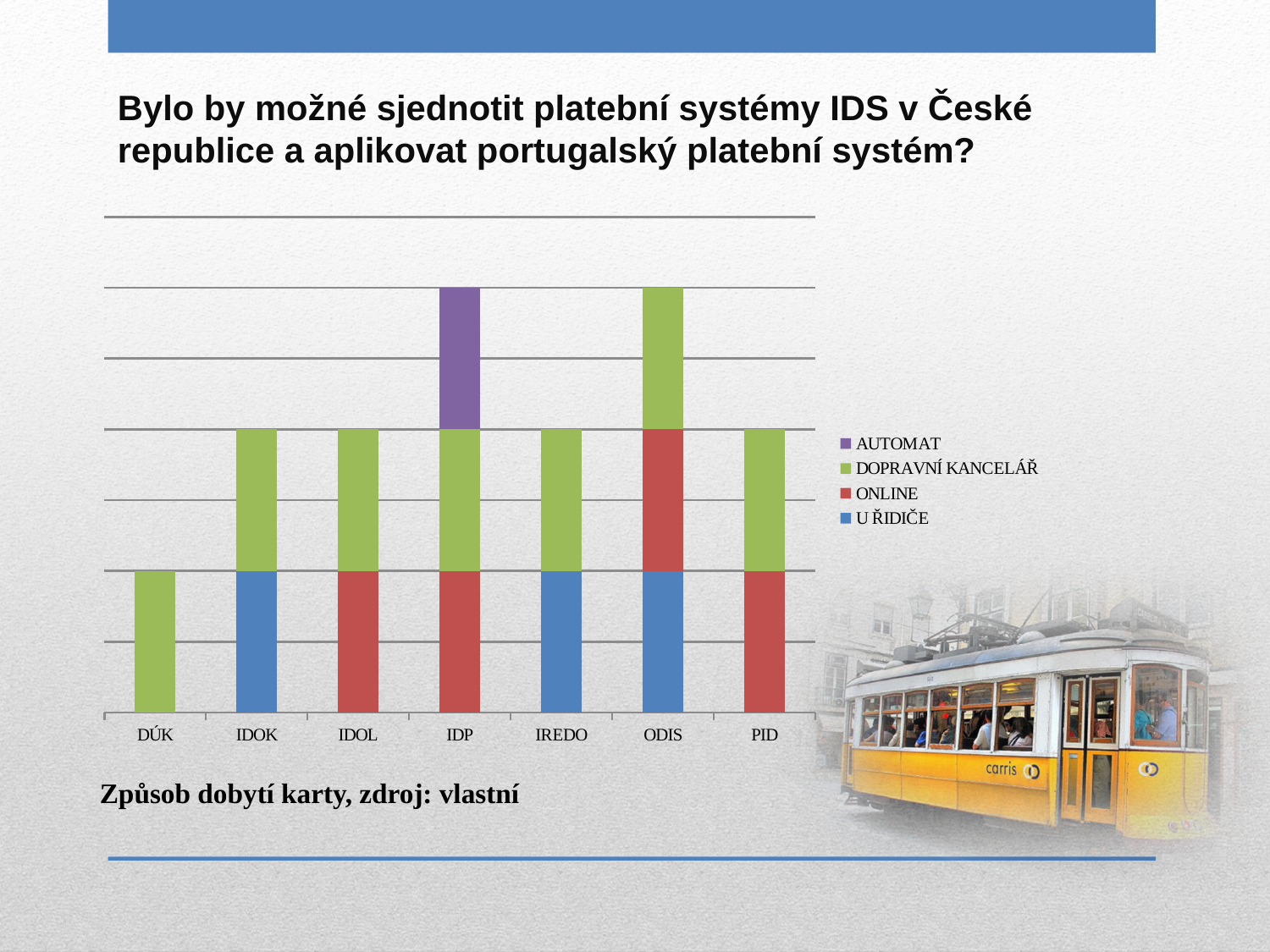
How many categories are shown on the x axis of the chart? 7 What colour represents the ONLINE series in the legend? Red What caption appears below the chart? Způsob dobytí karty, zdroj: vlastní Which stacked bar is taller, ODIS or PID? ODIS What kind of chart is shown on the slide? Stacked bar chart Which category has the shortest stacked bar in the chart? DÚK How many segments make up the ODIS bar? 3 Which category's bar consists of only a DOPRAVNÍ KANCELÁŘ segment? DÚK How many series does the chart's legend list? 4 Which category is the only one with an AUTOMAT segment in its bar? IDP Which stacked bar is taller, IDP or DÚK? IDP Which categories have a U ŘIDIČE segment in their bars? IDOK, IREDO, ODIS